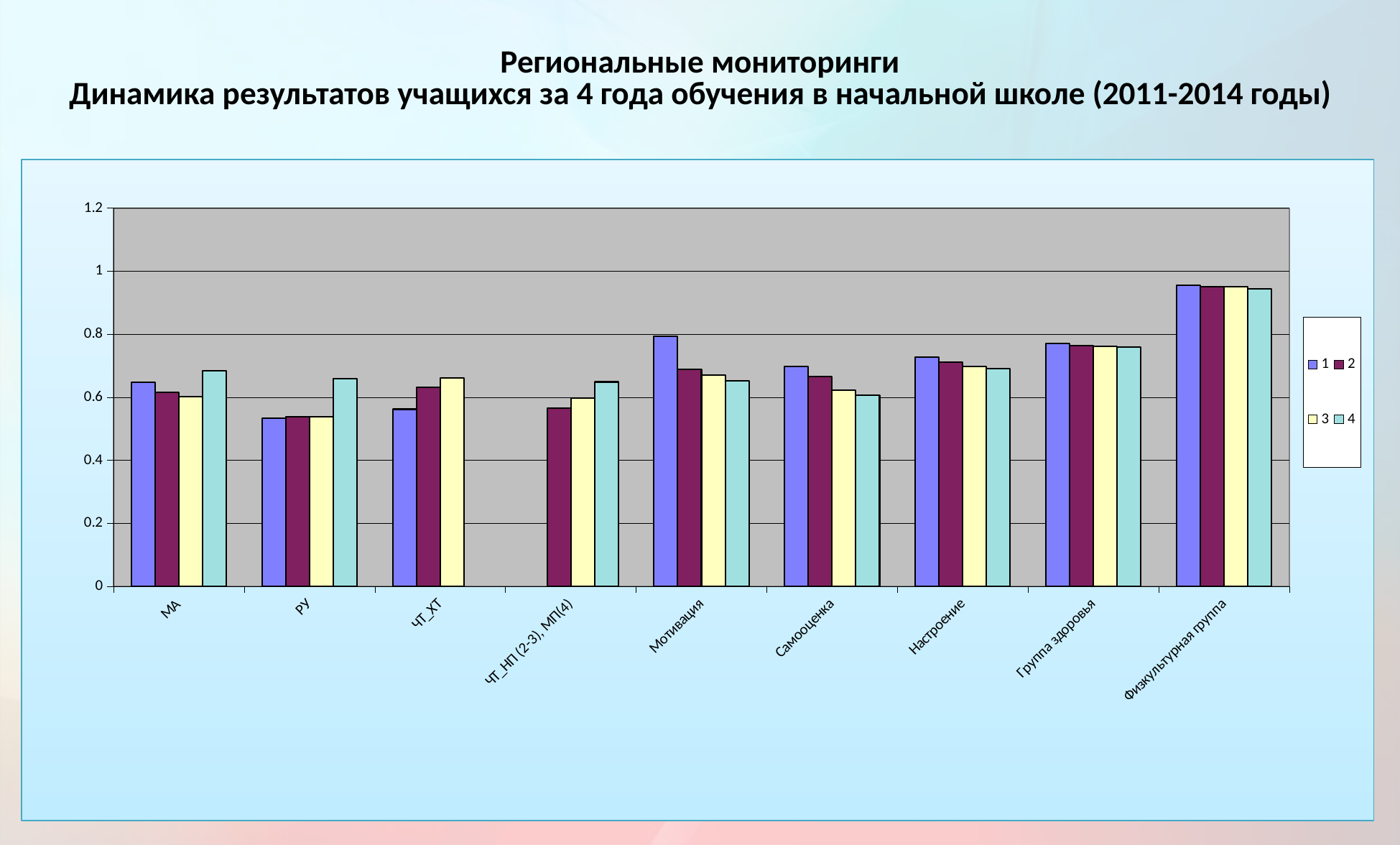
Is the value for series 1 in Группа здоровья greater or less than 0.8? less What are the entries listed in the legend? 1, 2, 3, 4 Is the value for series 1 in Физкультурная группа greater or less than 1? less Is the value for series 1 in МА greater or less than 0.6? greater What kind of chart is shown on the slide? bar chart How many categories are shown on the x axis? 9 For series 1, which is larger: Мотивация or Самооценка? Мотивация Which category has the highest values across all series? Физкультурная группа How many series does the legend list? 4 Which category has the lowest value for series 1? РУ In the Мотивация category, do the values rise or fall from series 1 to series 4? fall